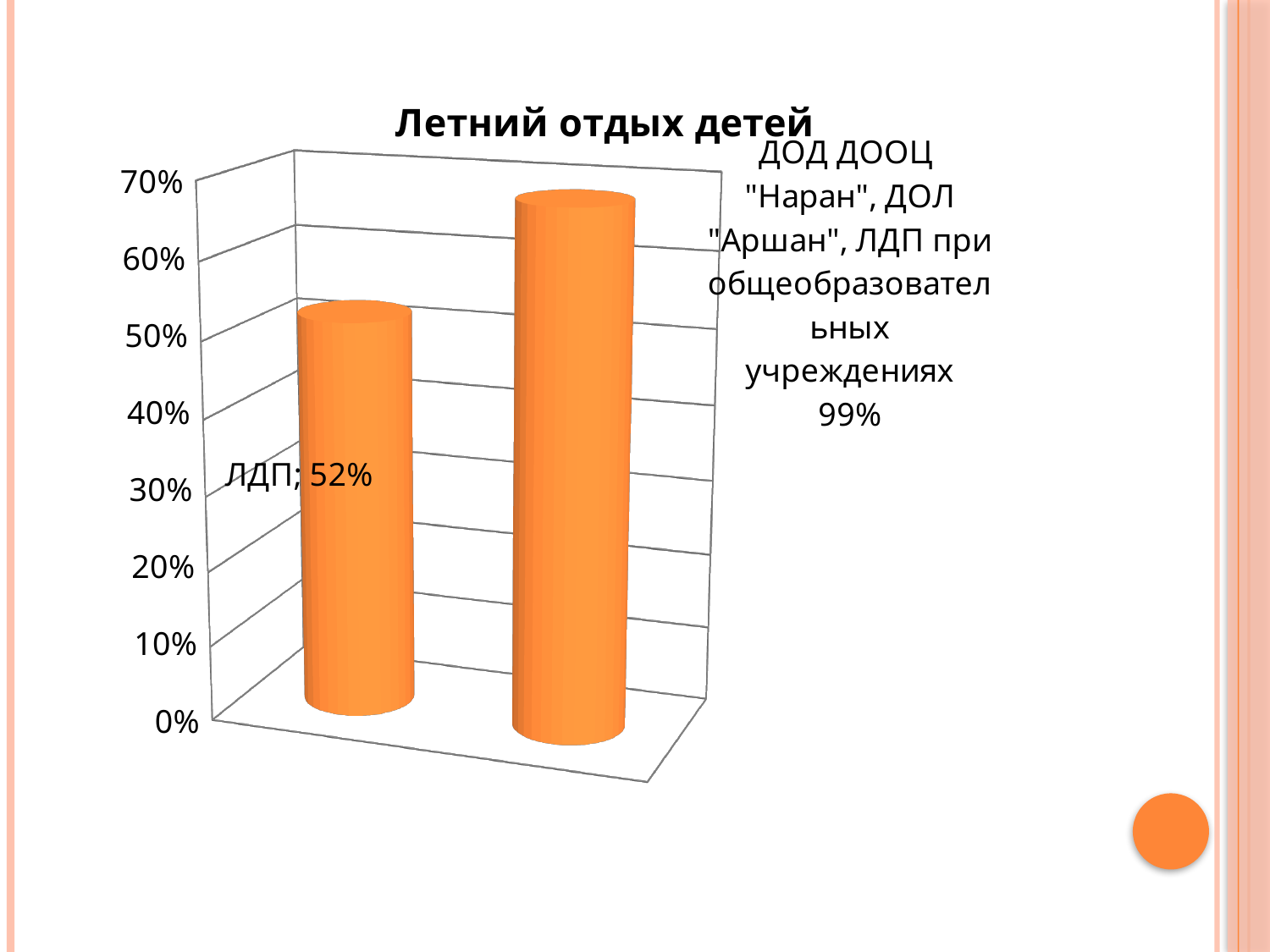
What is the title of the chart? Летний отдых детей What kind of chart is shown on the slide? bar chart Which category has the lowest value? ЛДП What is the highest value shown on the vertical axis? 70% Is the value for ЛДП greater or less than 40%? greater Which is larger: the value for ЛДП or the value for ДОД ДООЦ "Наран", ДОЛ "Аршан", ЛДП при общеобразовательных учреждениях? ДОД ДООЦ "Наран", ДОЛ "Аршан", ЛДП при общеобразовательных учреждениях What is the value for ЛДП? 52% Which category has the highest value? ДОД ДООЦ "Наран", ДОЛ "Аршан", ЛДП при общеобразовательных учреждениях How many bars are shown in the chart? 2 Is the value for ДОД ДООЦ "Наран", ДОЛ "Аршан", ЛДП при общеобразовательных учреждениях greater or less than 60%? greater